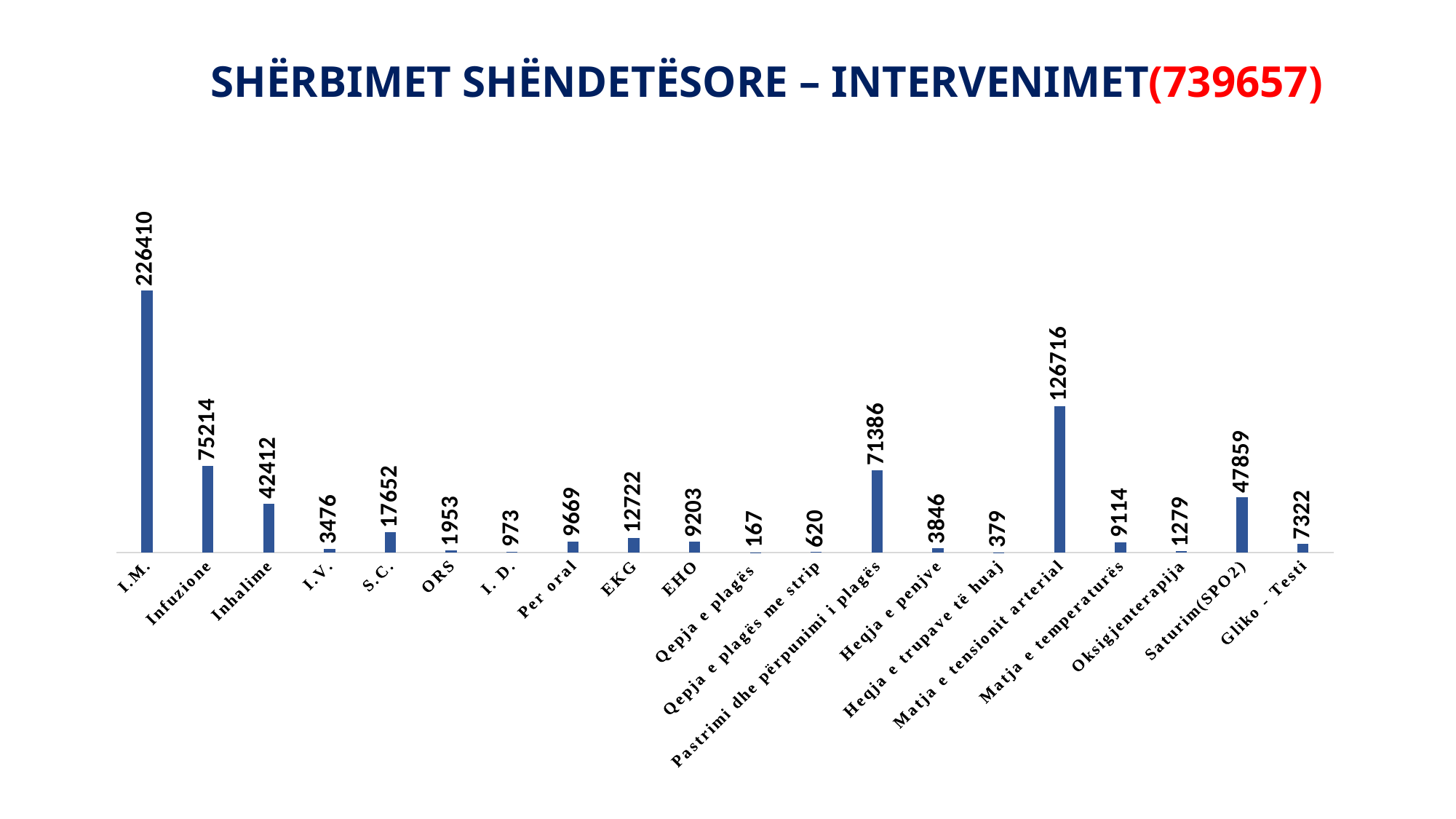
What is the difference between the values for I.M. and Matja e tensionit arterial? 99694 How many categories are shown on the x axis? 20 What number appears in red in the chart title? 739657 What is the value for Saturim(SPO2)? 47859 What is the value for Matja e tensionit arterial? 126716 What is the difference between the values for Infuzione and Inhalime? 32802 What kind of chart is shown on the slide? Bar chart Which category has the lowest value? Qepja e plagës What is the value for I.M.? 226410 What is the value for Heqja e trupave të huaj? 379 Which is larger, the value for Infuzione or the value for Pastrimi dhe përpunimi i plagës? Infuzione Which category has the highest value? I.M.